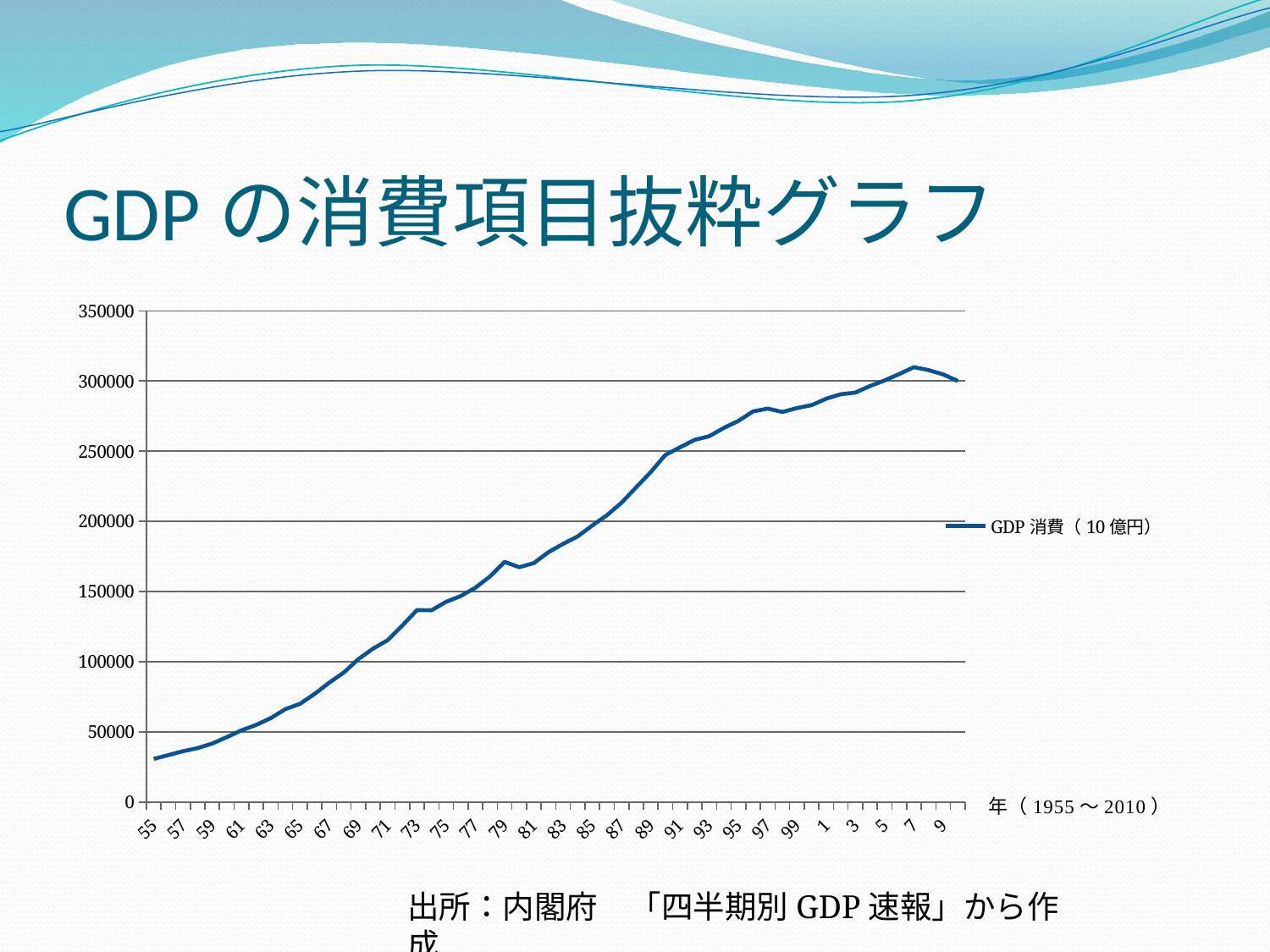
How many series does the legend list? 1 What is the label of the x axis? 年（1955～2010） Is the value for 7 greater or less than 300000? greater Is the value for 55 greater or less than 50000? less Do the values generally rise or fall from 55 to 9 along the x axis? rise What is the legend entry for the plotted series? GDP 消費（10 億円） Which is larger, the value for 73 or the value for 89? 89 What kind of chart is shown on the slide? line chart Which x-axis label has the lowest value? 55 Is the value for 81 greater or less than 150000? greater